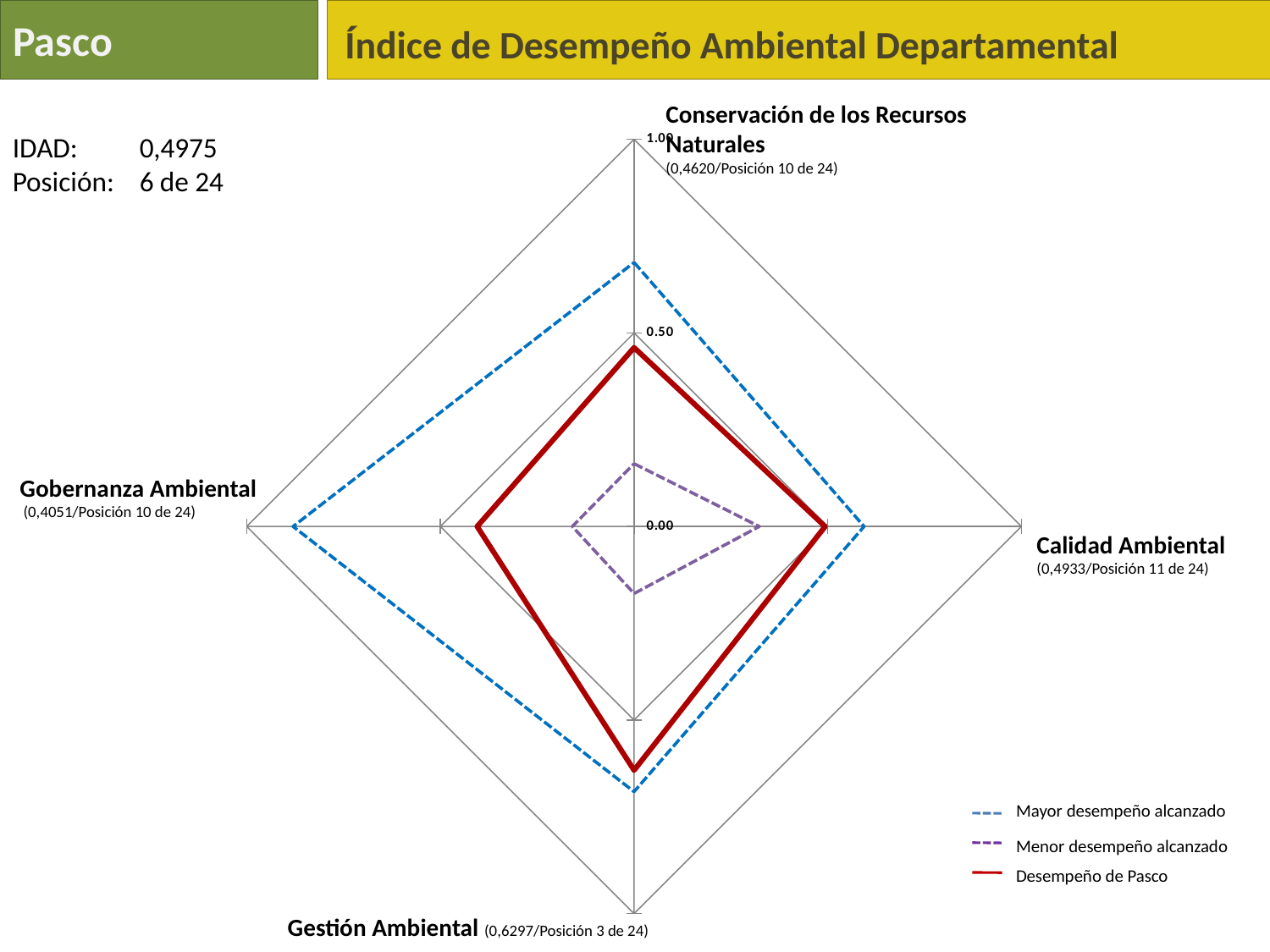
Is the 'Mayor desempeño alcanzado' value for Gobernanza Ambiental greater or less than 0.50? greater What is Pasco's value for Gestión Ambiental? 0,6297 What is Pasco's value for Conservación de los Recursos Naturales? 0,4620 In which category does Pasco have its lowest value? Gobernanza Ambiental What is Pasco's value for Calidad Ambiental? 0,4933 In which category does Pasco have its highest value? Gestión Ambiental What type of chart is shown on the slide? Radar chart What is Pasco's value for Gobernanza Ambiental? 0,4051 What is the difference between Pasco's Gestión Ambiental value and its Gobernanza Ambiental value? 0,2246 How many axes (categories) does the radar chart have? 4 How many series does the legend list? 3 Which series is drawn as a solid red line? Desempeño de Pasco